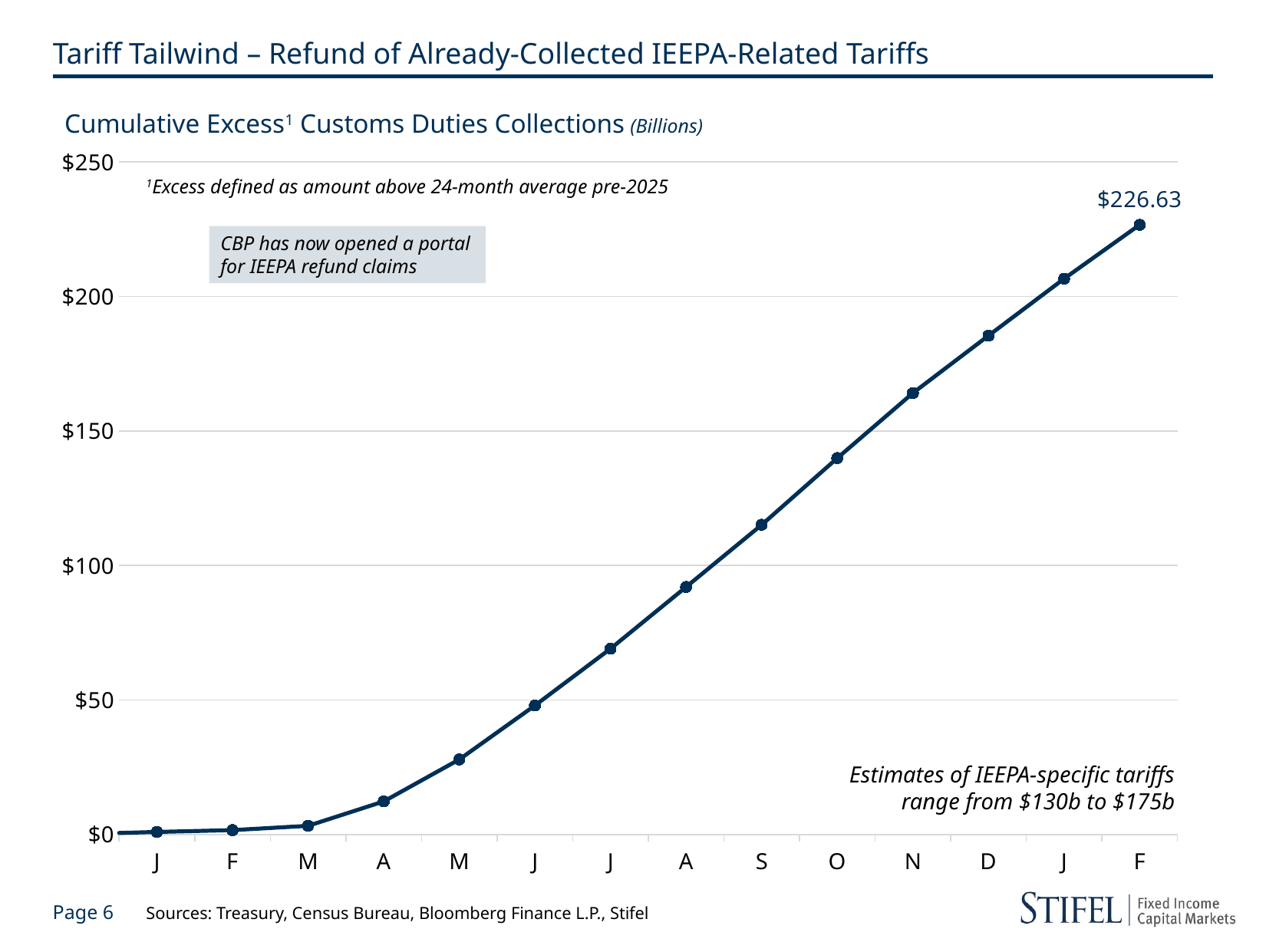
Do the values rise or fall from left to right along the x axis? Rise Is the value for S greater or less than $100? greater Which month on the x axis has the lowest cumulative excess customs duties collections? J (the first point) What is the title of the chart? Cumulative Excess Customs Duties Collections (Billions) Which month on the x axis has the highest cumulative excess customs duties collections? F (the last point) What kind of chart is shown on the slide? Line chart Is the value for the second-to-last point (J) greater or less than $200? greater Is the value for O greater or less than $150? less What is the value printed at the final point (F) of the line? $226.63 Which is larger, the value for N or the value for S? N How many data points are plotted on the line? 14